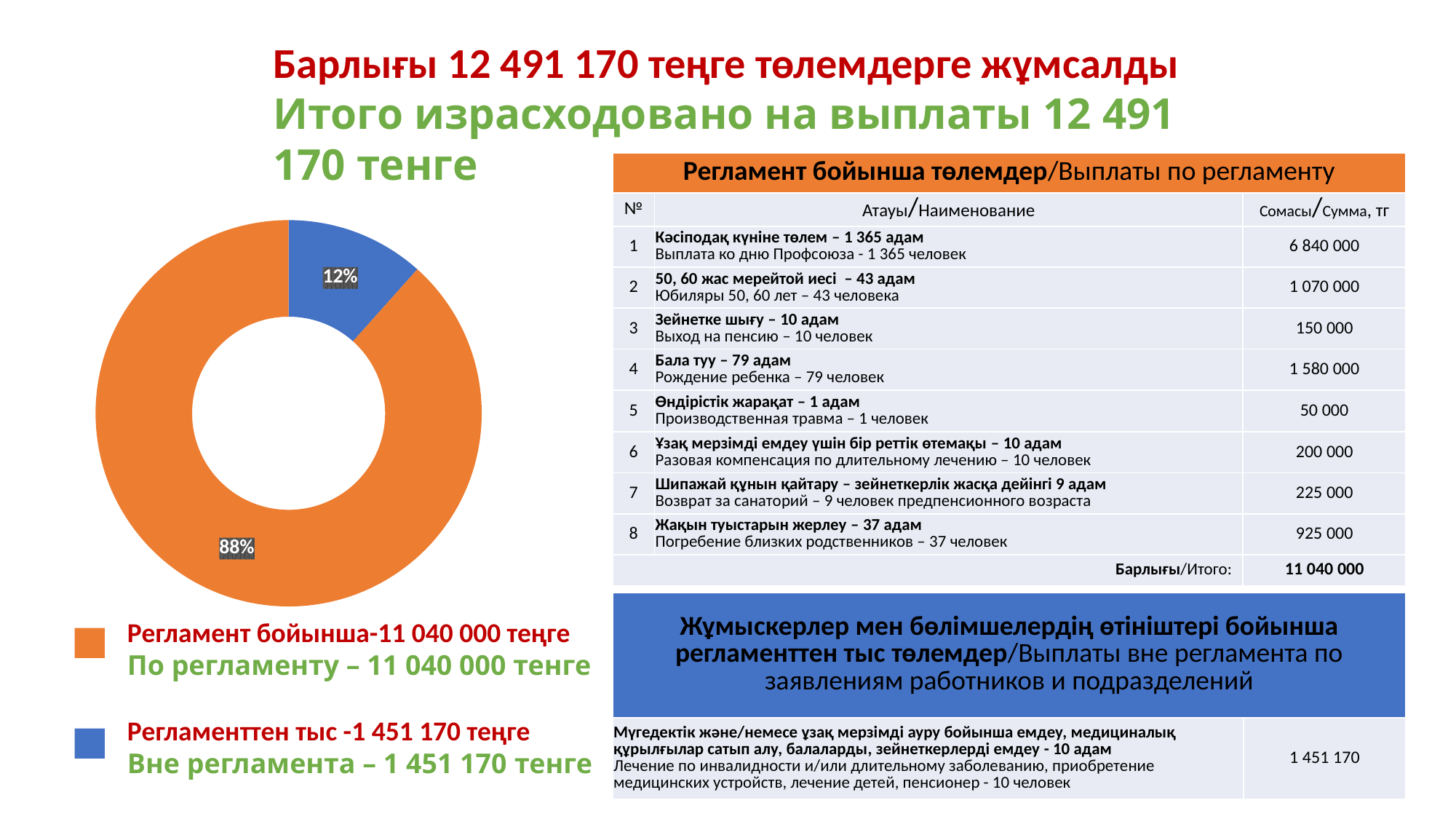
Which category has the smallest slice in the donut chart? Вне регламента (Регламенттен тыс) What colour represents По регламенту in the donut chart? Orange Which category has the largest slice in the donut chart? По регламенту (Регламент бойынша) What share of the donut chart is labelled for the orange slice (По регламенту)? 88% Which slice is larger in the donut chart: По регламенту or Вне регламента? По регламенту According to the legend, what amount corresponds to По регламенту? 11 040 000 тенге How many slices does the donut chart have? 2 What kind of chart is shown on the left of the slide? Pie (donut) chart What is the difference in percentage points between the 88% slice and the 12% slice? 76 percentage points According to the legend, what amount corresponds to Вне регламента? 1 451 170 тенге What colour represents Вне регламента in the donut chart? Blue What share of the donut chart is labelled for the blue slice (Вне регламента)? 12%